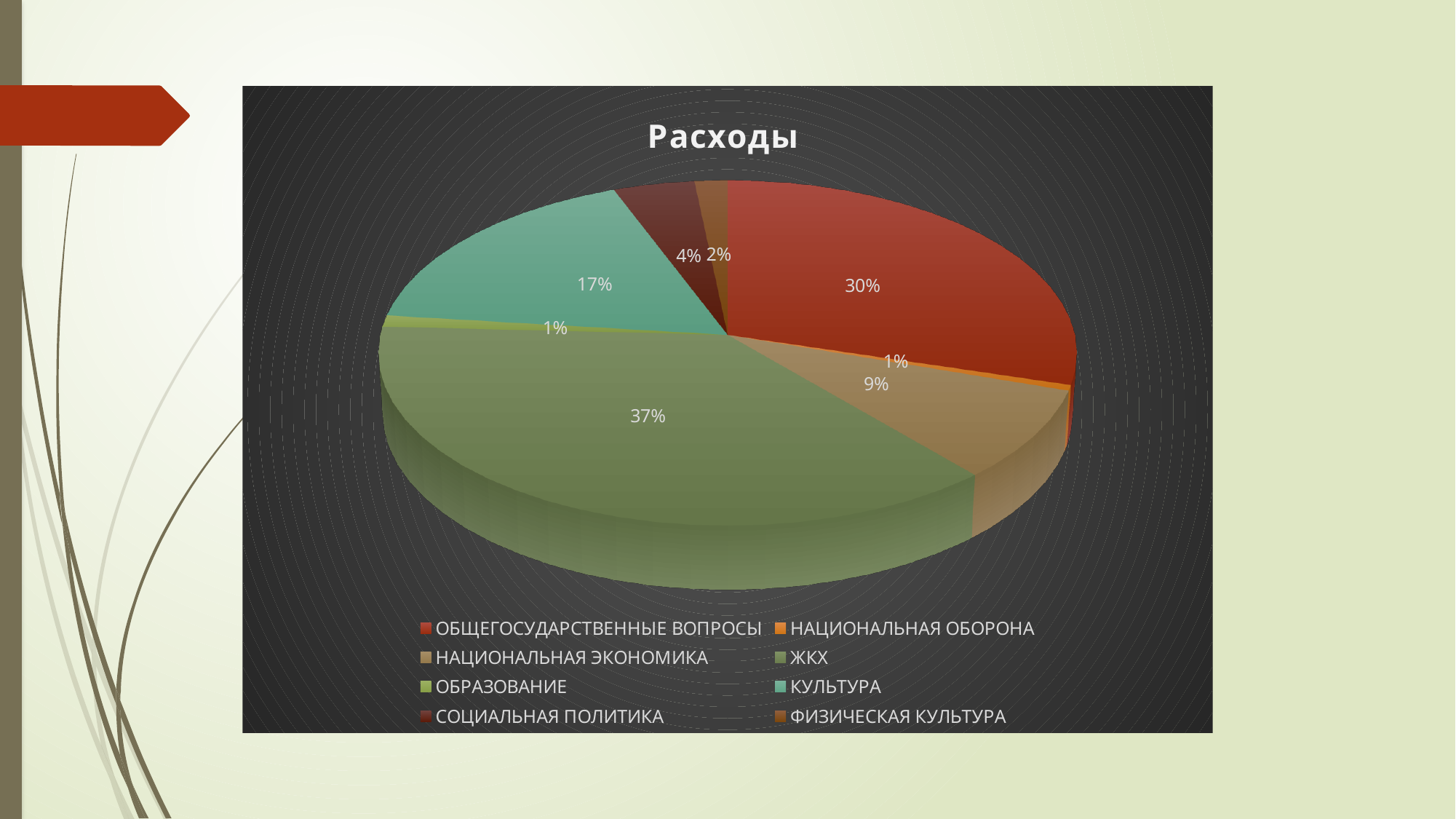
What share of the pie does СОЦИАЛЬНАЯ ПОЛИТИКА take? 4% What share of the pie does НАЦИОНАЛЬНАЯ ЭКОНОМИКА take? 9% What kind of chart is shown on the slide? pie chart Which category has the largest slice of the pie? ЖКХ What colour is the slice for КУЛЬТУРА? teal What is the title of the chart? Расходы What share of the pie does КУЛЬТУРА take? 17% Which is larger, the slice for ОБЩЕГОСУДАРСТВЕННЫЕ ВОПРОСЫ or the slice for КУЛЬТУРА? ОБЩЕГОСУДАРСТВЕННЫЕ ВОПРОСЫ What is the difference in percentage points between the ЖКХ slice and the ОБЩЕГОСУДАРСТВЕННЫЕ ВОПРОСЫ slice? 7% How many categories does the legend of the chart list? 8